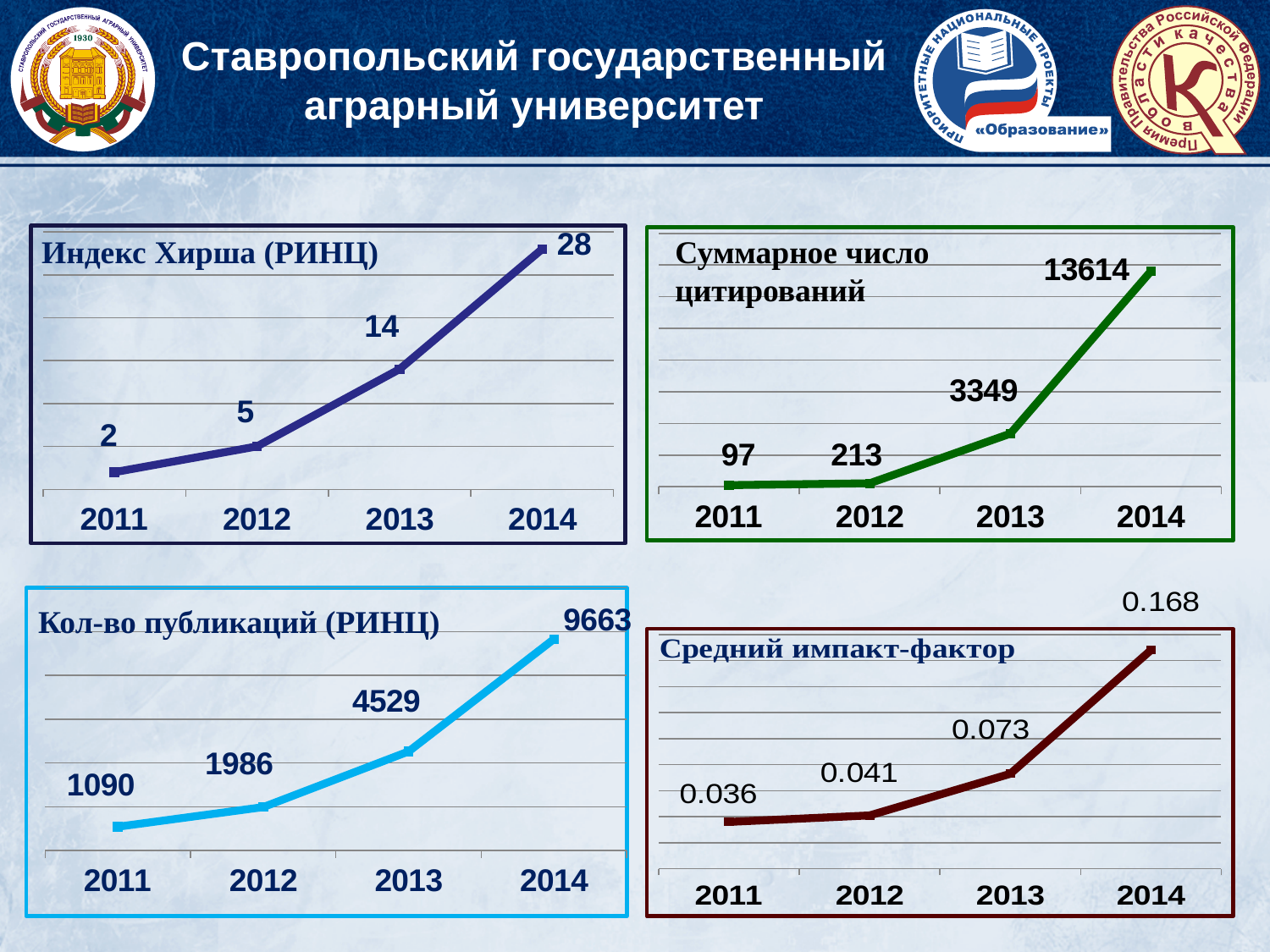
In the 'Суммарное число цитирований' chart, what is the value for 2014? 13614 How many data points are plotted in the 'Кол-во публикаций (РИНЦ)' chart? 4 In the 'Индекс Хирша (РИНЦ)' chart, what is the difference between the 2014 and 2013 values? 14 In the 'Средний импакт-фактор' chart, what is the value for 2011? 0.036 In the 'Средний импакт-фактор' chart, is the value for 2013 larger or smaller than the value for 2012? larger What type of chart is the 'Средний импакт-фактор' chart? line chart In the 'Кол-во публикаций (РИНЦ)' chart, what is the value for 2012? 1986 In the 'Индекс Хирша (РИНЦ)' chart, do the values rise or fall from 2011 to 2014? rise In the 'Суммарное число цитирований' chart, which year has the lowest value? 2011 In the 'Индекс Хирша (РИНЦ)' chart, what is the value for 2013? 14 In the 'Кол-во публикаций (РИНЦ)' chart, which year has the highest value? 2014 In the 'Суммарное число цитирований' chart, what is the difference between the 2013 and 2012 values? 3136